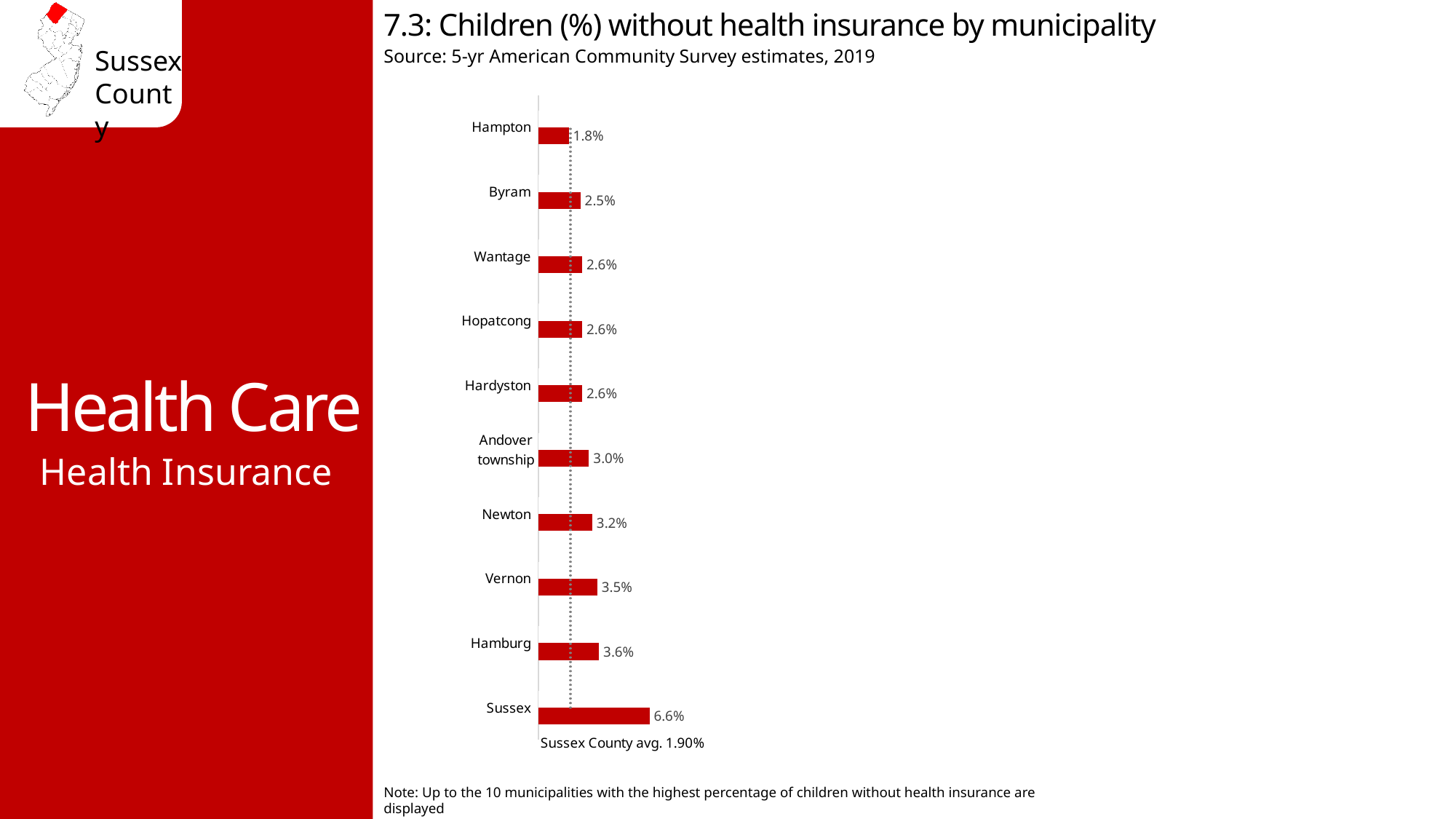
Which municipality has the lowest percentage of children without health insurance? Hampton What is the difference between the values for Sussex and Hamburg? 3.0% What is the value shown for Hampton? 1.8% What type of chart is shown on the slide? Bar chart What percentage is shown for Newton? 3.2% What is the value for Andover township? 3.0% What is the Sussex County average shown by the dotted line? 1.90% Which municipality has the highest percentage of children without health insurance? Sussex What is the source of the data in the chart? 5-yr American Community Survey estimates, 2019 How many municipalities are shown in the chart? 10 What percentage of children in Sussex are without health insurance? 6.6% Which has a higher value, Vernon or Byram? Vernon